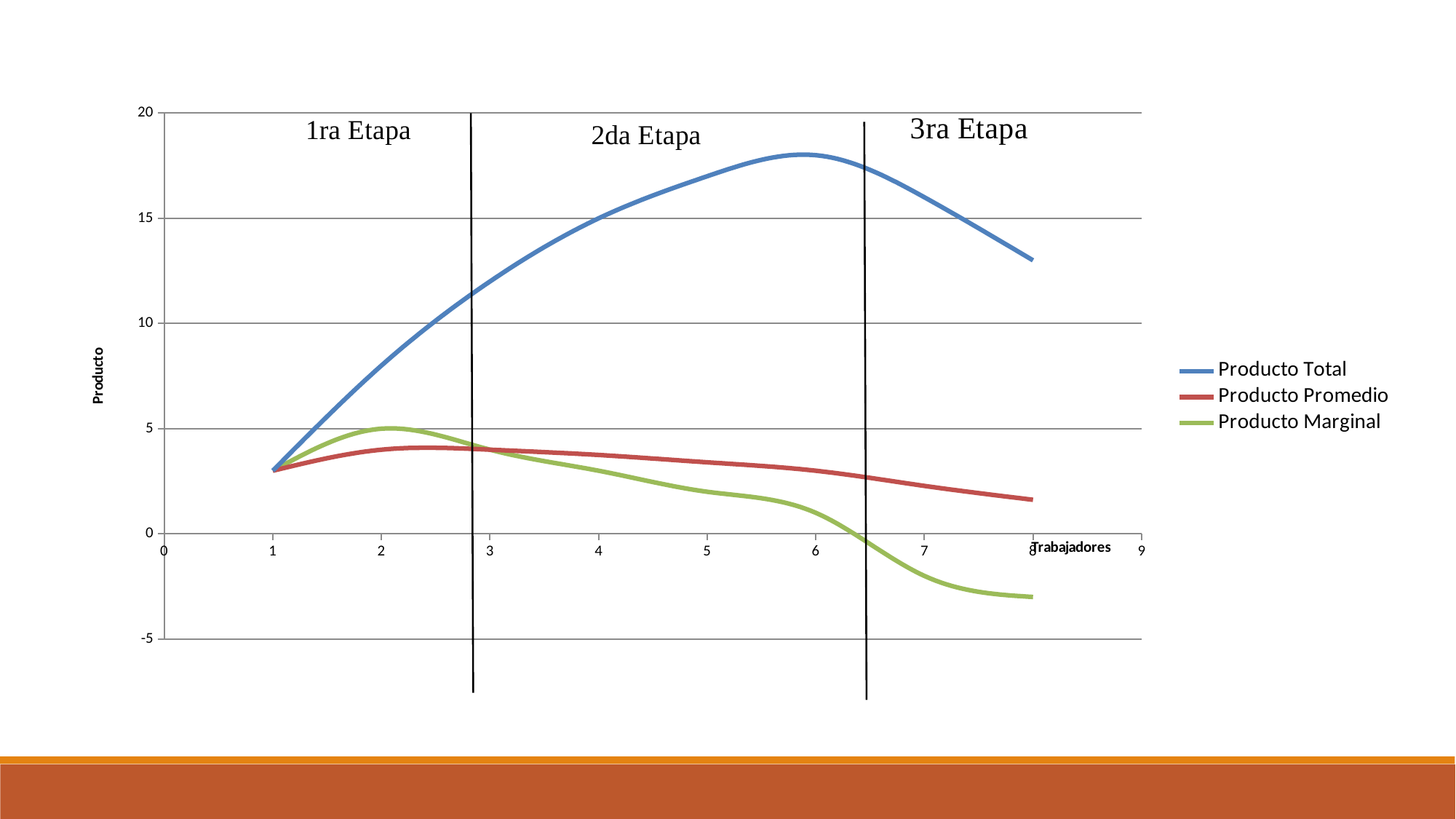
Does Producto Total rise or fall between 1 and 6 Trabajadores? rise Does Producto Promedio rise or fall between 3 and 8 Trabajadores? fall What are the three series named in the legend? Producto Total, Producto Promedio, Producto Marginal What is the title of the x axis? Trabajadores How many series does the legend list? 3 At 8 Trabajadores, which series has the larger value, Producto Promedio or Producto Marginal? Producto Promedio At 2 Trabajadores, which series has the larger value, Producto Total or Producto Marginal? Producto Total Is the value of Producto Promedio at 8 Trabajadores greater or less than 5? less Is the value of Producto Total at 6 Trabajadores greater or less than 15? greater Is the value of Producto Total at 8 Trabajadores greater or less than 10? greater What kind of chart is shown on the slide? line chart